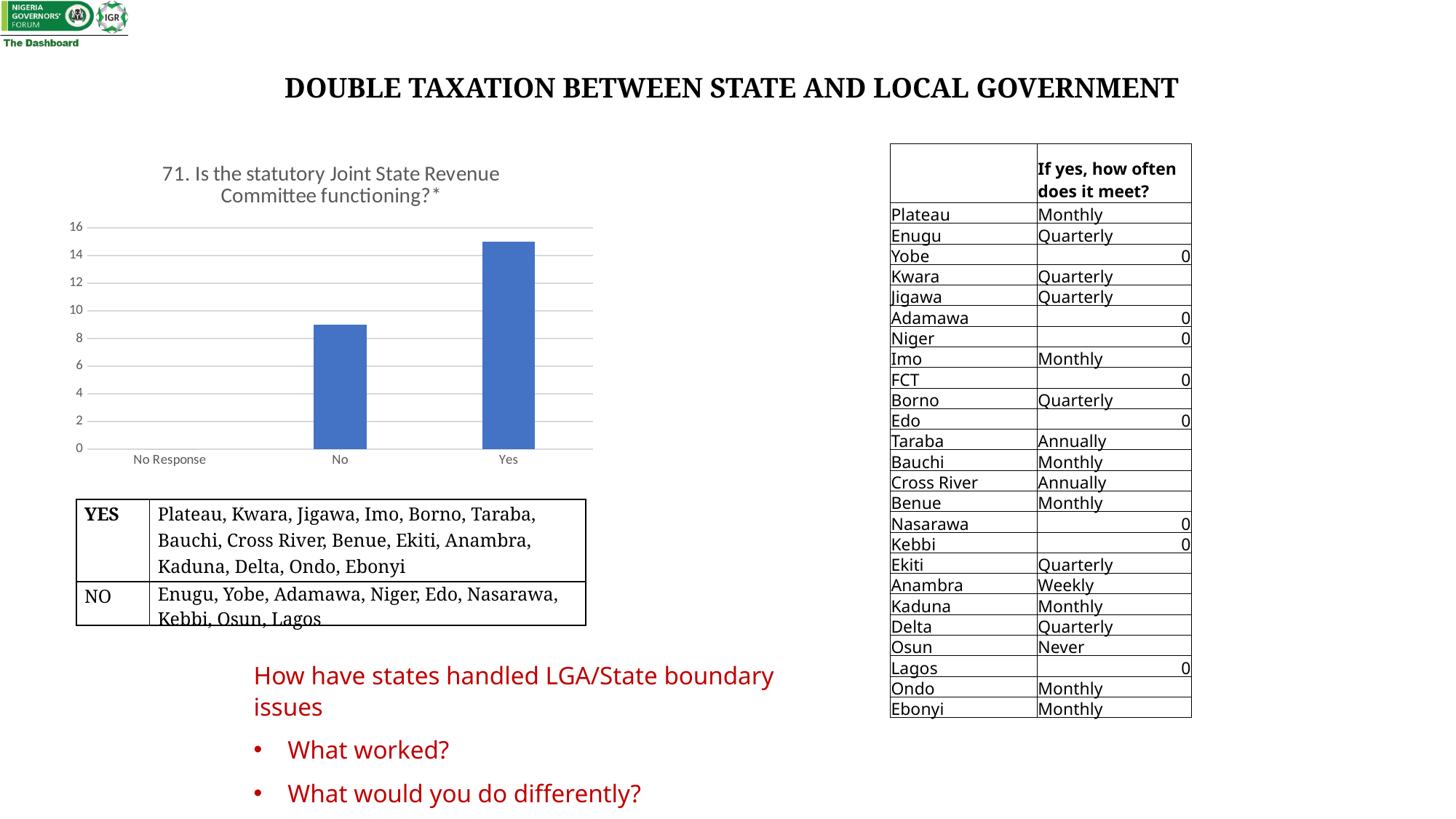
How many categories are shown on the x axis of the chart? 3 Which is larger in the chart, the value for Yes or the value for No? Yes Which category has the highest value in the chart? Yes Is the value for No greater or less than 10? less What is the title of the chart? 71. Is the statutory Joint State Revenue Committee functioning?* Which category has the lowest value in the chart? No Response What kind of chart is shown on the slide? bar chart Is the value for No greater or less than 8? greater What is the highest value shown on the chart's vertical axis? 16 Is the value for Yes greater or less than 14? greater Do the bar values rise or fall moving from left to right along the x axis? rise